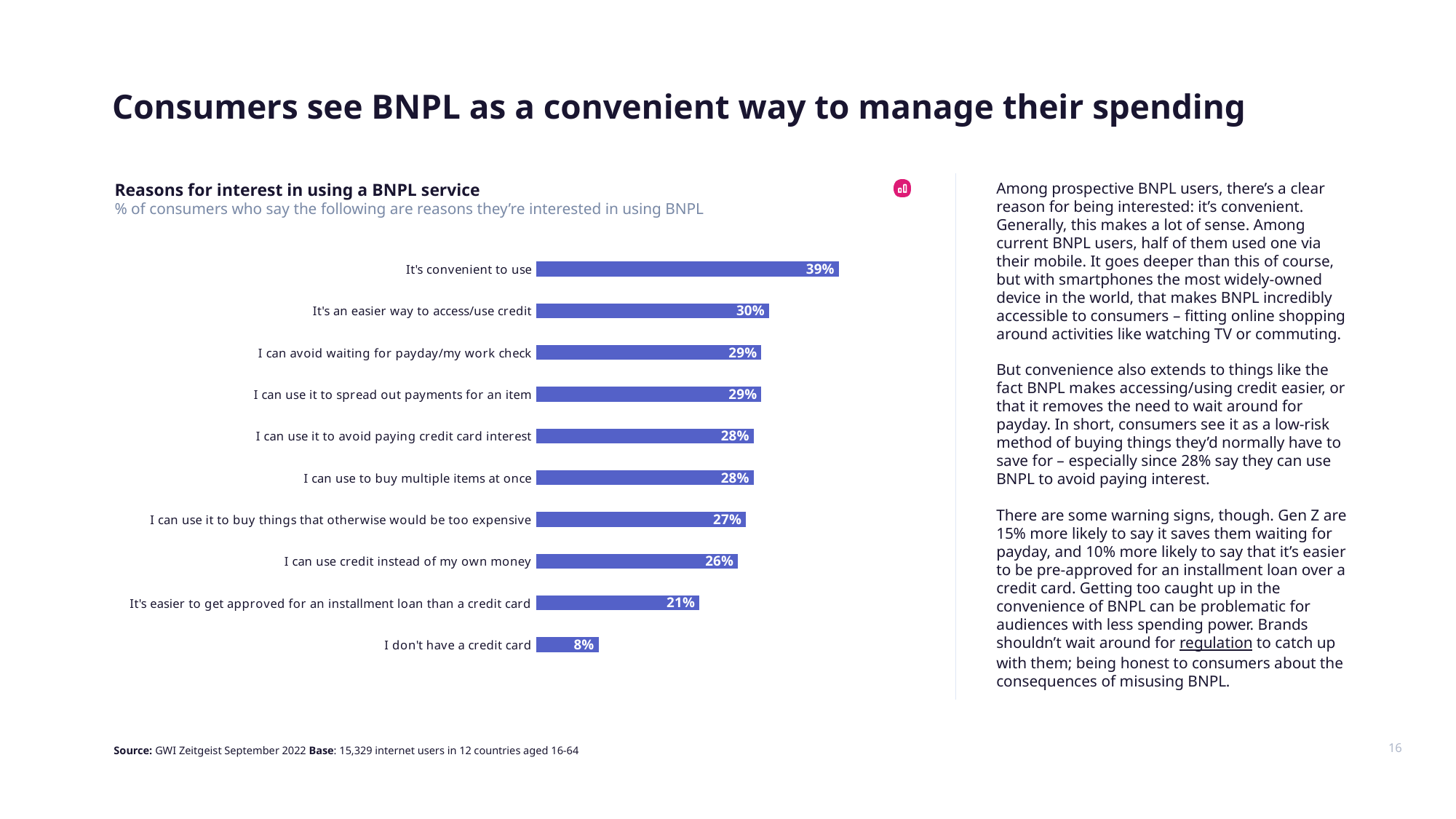
Which is larger: "I can use credit instead of my own money" or "It's easier to get approved for an installment loan than a credit card"? I can use credit instead of my own money How many reasons are listed in the chart? 10 What is the title of the chart? Reasons for interest in using a BNPL service What is the value for "I can use it to buy things that otherwise would be too expensive"? 27% What percentage is shown for "It's easier to get approved for an installment loan than a credit card"? 21% What kind of chart is shown on the slide? Bar chart What is the difference between "It's convenient to use" and "It's an easier way to access/use credit"? 9 percentage points Which reason has the lowest percentage? I don't have a credit card What is the difference between "I can use it to avoid paying credit card interest" and "I don't have a credit card"? 20 percentage points Which reason has the highest percentage? It's convenient to use What percentage of consumers say "It's convenient to use" is a reason they're interested in using BNPL? 39% What is the value for "I don't have a credit card"? 8%